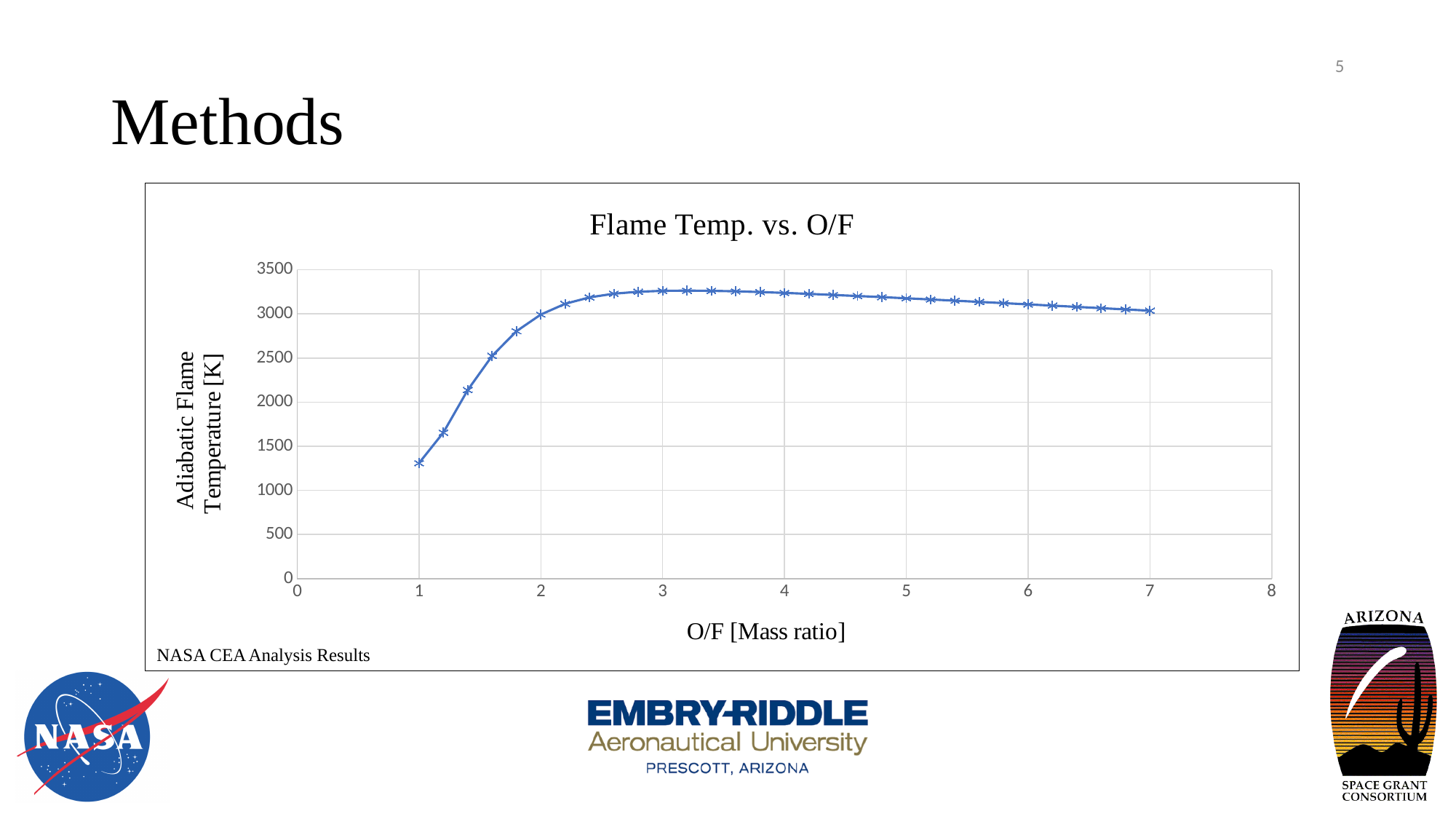
What kind of chart is shown on the slide? line chart At which O/F value is the adiabatic flame temperature lowest? 1 Is the adiabatic flame temperature at an O/F of 5 greater or less than 3000? greater Is the adiabatic flame temperature at an O/F of 3 greater or less than 3000? greater Is the adiabatic flame temperature at an O/F of 1.4 greater or less than 2000? greater What is the title of the chart? Flame Temp. vs. O/F Which has the higher adiabatic flame temperature, an O/F of 3 or an O/F of 7? 3 How does the adiabatic flame temperature change as O/F increases from 1 to 3? it rises Which has the higher adiabatic flame temperature, an O/F of 2 or an O/F of 4? 4 What is the label of the y axis? Adiabatic Flame Temperature [K]